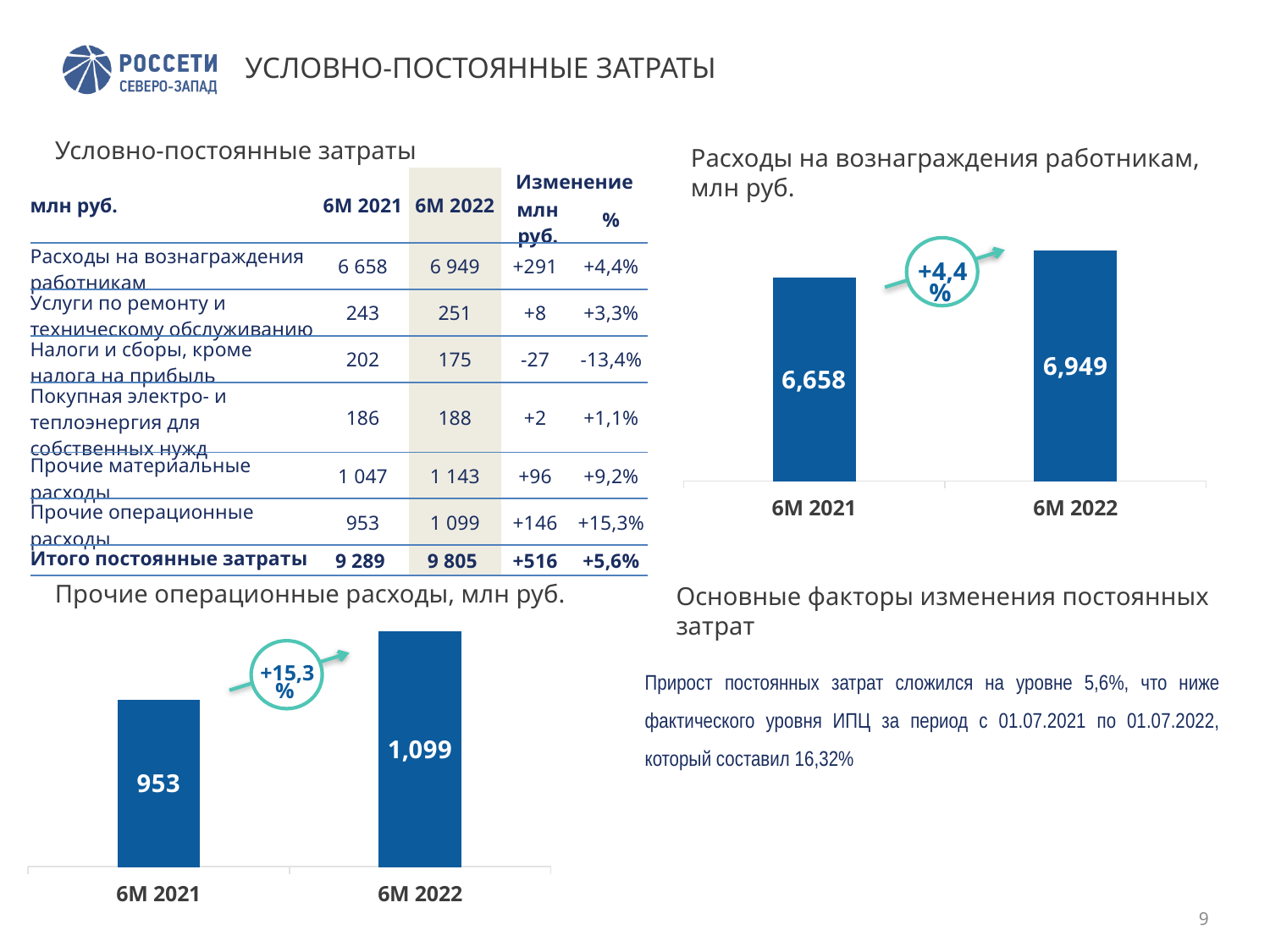
In the chart 'Прочие операционные расходы, млн руб.', which period has the lower value? 6M 2021 In the chart 'Расходы на вознаграждения работникам, млн руб.', what is the value for 6M 2021? 6,658 In the chart 'Расходы на вознаграждения работникам, млн руб.', which period has the higher value? 6M 2022 In the chart 'Прочие операционные расходы, млн руб.', what is the value for 6M 2022? 1,099 In the chart 'Расходы на вознаграждения работникам, млн руб.', what is the value for 6M 2022? 6,949 In the chart 'Расходы на вознаграждения работникам, млн руб.', what percentage change is shown between 6M 2021 and 6M 2022? +4,4% In the chart 'Прочие операционные расходы, млн руб.', what percentage change is shown between 6M 2021 and 6M 2022? +15,3% How many categories are shown on the x axis of the chart 'Расходы на вознаграждения работникам, млн руб.'? 2 In the chart 'Расходы на вознаграждения работникам, млн руб.', what is the difference between the 6M 2022 and 6M 2021 values? 291 In the chart 'Прочие операционные расходы, млн руб.', what is the difference between the 6M 2022 and 6M 2021 values? 146 In the chart 'Прочие операционные расходы, млн руб.', what is the value for 6M 2021? 953 What type of chart is 'Прочие операционные расходы, млн руб.'? Bar chart